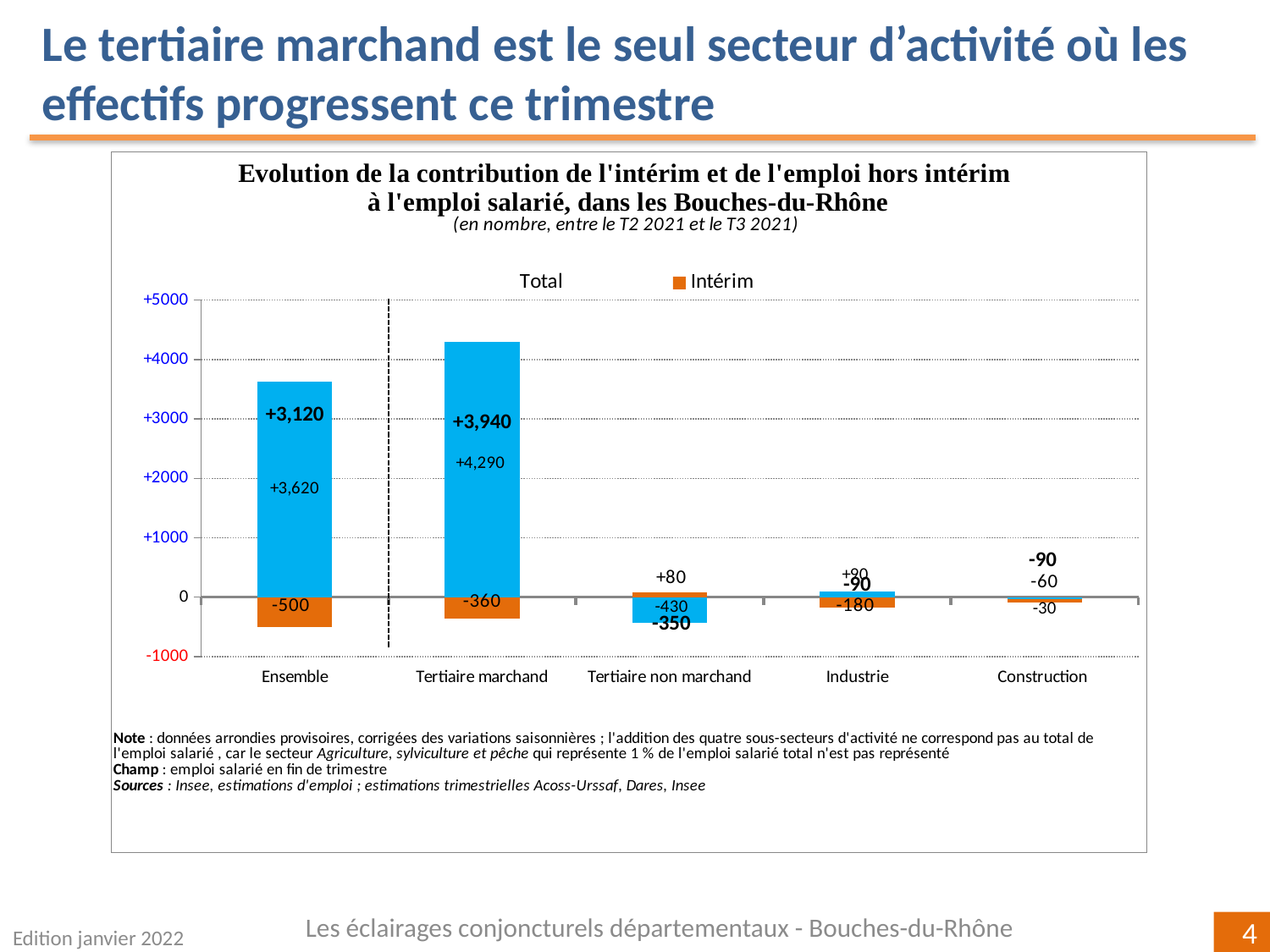
What is the Total value (bold label) for Tertiaire marchand? +3,940 Which has the larger Intérim decline, Ensemble or Tertiaire marchand? Ensemble What is the Intérim value for Tertiaire marchand? -360 What is the Total value (bold label) for Ensemble? +3,120 What is the Intérim value for Ensemble? -500 Which two entries are listed in the chart legend? Total and Intérim What kind of chart is shown on the slide? bar chart What is the Intérim value for Industrie? -180 Which category has the highest Total value? Tertiaire marchand What is the Total value (bold label) for Tertiaire non marchand? -350 What is the difference between the blue bar value for Tertiaire marchand (+4,290) and the blue bar value for Ensemble (+3,620)? 670 How many sector categories are shown on the x axis of the chart? 5